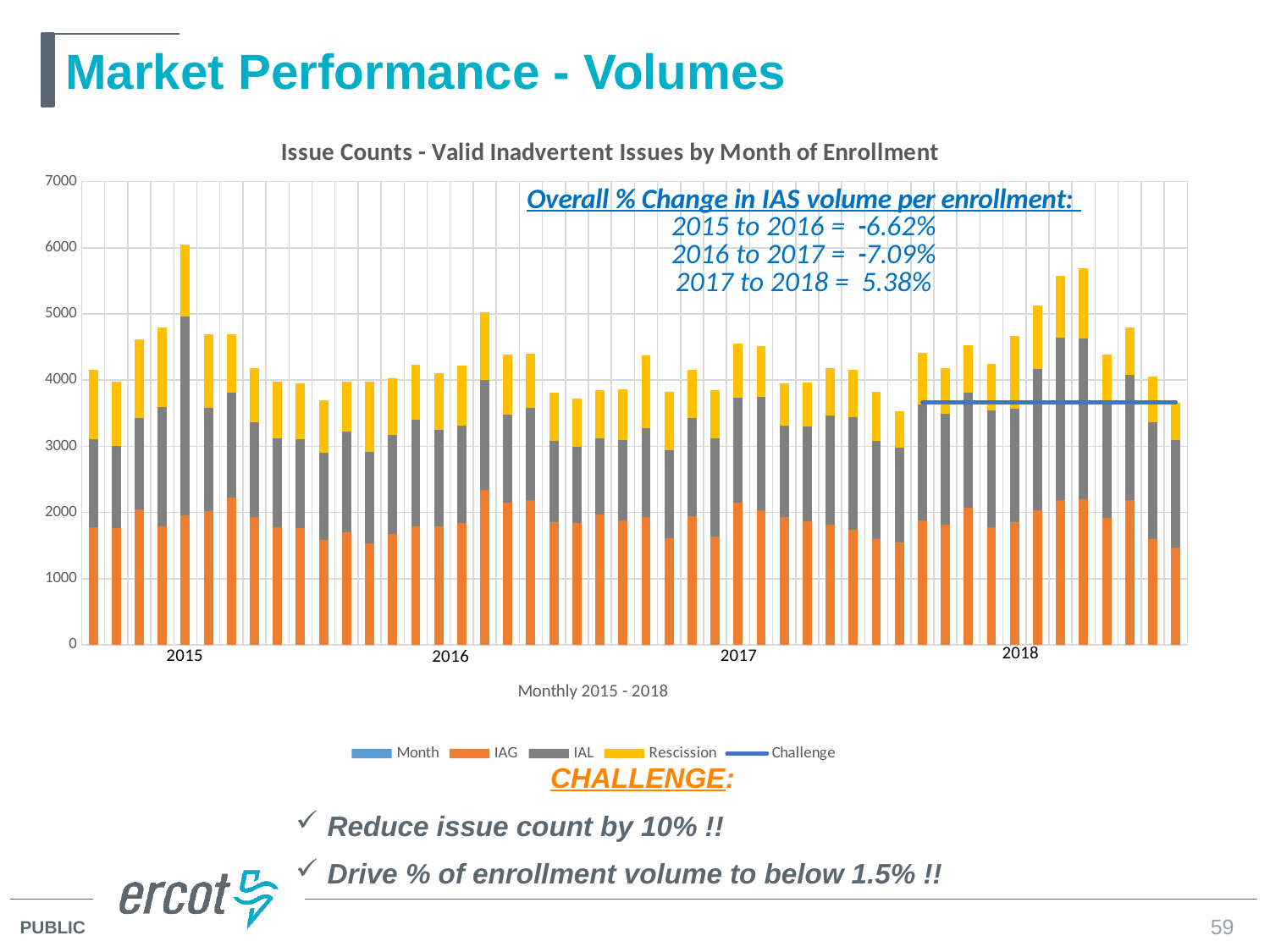
What kind of chart is shown on the slide? Stacked bar chart with a line (combination bar and line chart) Is the Challenge line in the chart greater or less than 3000? greater How many series does the chart legend list? 5 What is the title of the chart? Issue Counts - Valid Inadvertent Issues by Month of Enrollment Which year's annotated % change in IAS volume per enrollment is the only positive one? 2017 to 2018 Is the tallest bar in the chart greater or less than 5000? greater According to the annotation on the chart, what is the overall % change in IAS volume per enrollment from 2015 to 2016? -6.62% According to the annotation on the chart, what is the overall % change in IAS volume per enrollment from 2017 to 2018? 5.38% How many years are labelled along the x axis of the chart? 4 Is the shortest bar in the chart greater or less than 3000? greater Which legend entry is shown in yellow? Rescission